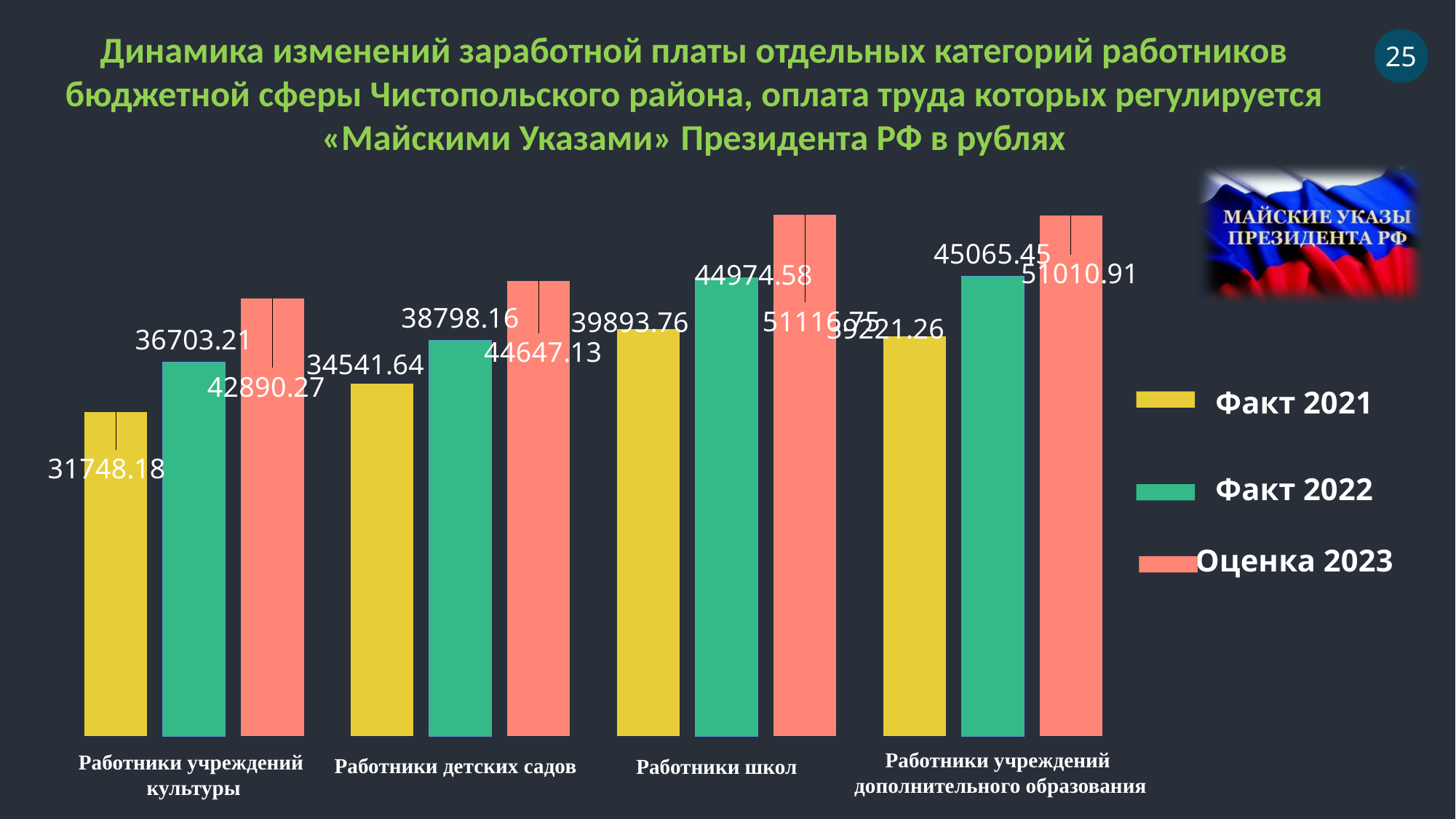
Which category has the lowest Факт 2021 value? Работники учреждений культуры What is the Оценка 2023 value for Работники учреждений дополнительного образования? 51010.91 How many series does the legend list? 3 What is the Факт 2021 value for Работники учреждений культуры? 31748.18 What is the Факт 2022 value for Работники учреждений дополнительного образования? 45065.45 What is the Оценка 2023 value for Работники детских садов? 44647.13 Which is larger: the Факт 2021 value for Работники школ or for Работники учреждений дополнительного образования? Работники школ What kind of chart is shown on the slide? bar chart Within each category, do the values rise or fall from Факт 2021 to Оценка 2023? rise What is the difference between the Оценка 2023 and Факт 2022 values for Работники детских садов? 5848.97 What is the difference between the Факт 2022 and Факт 2021 values for Работники учреждений культуры? 4955.03 How many worker categories are shown on the x axis? 4